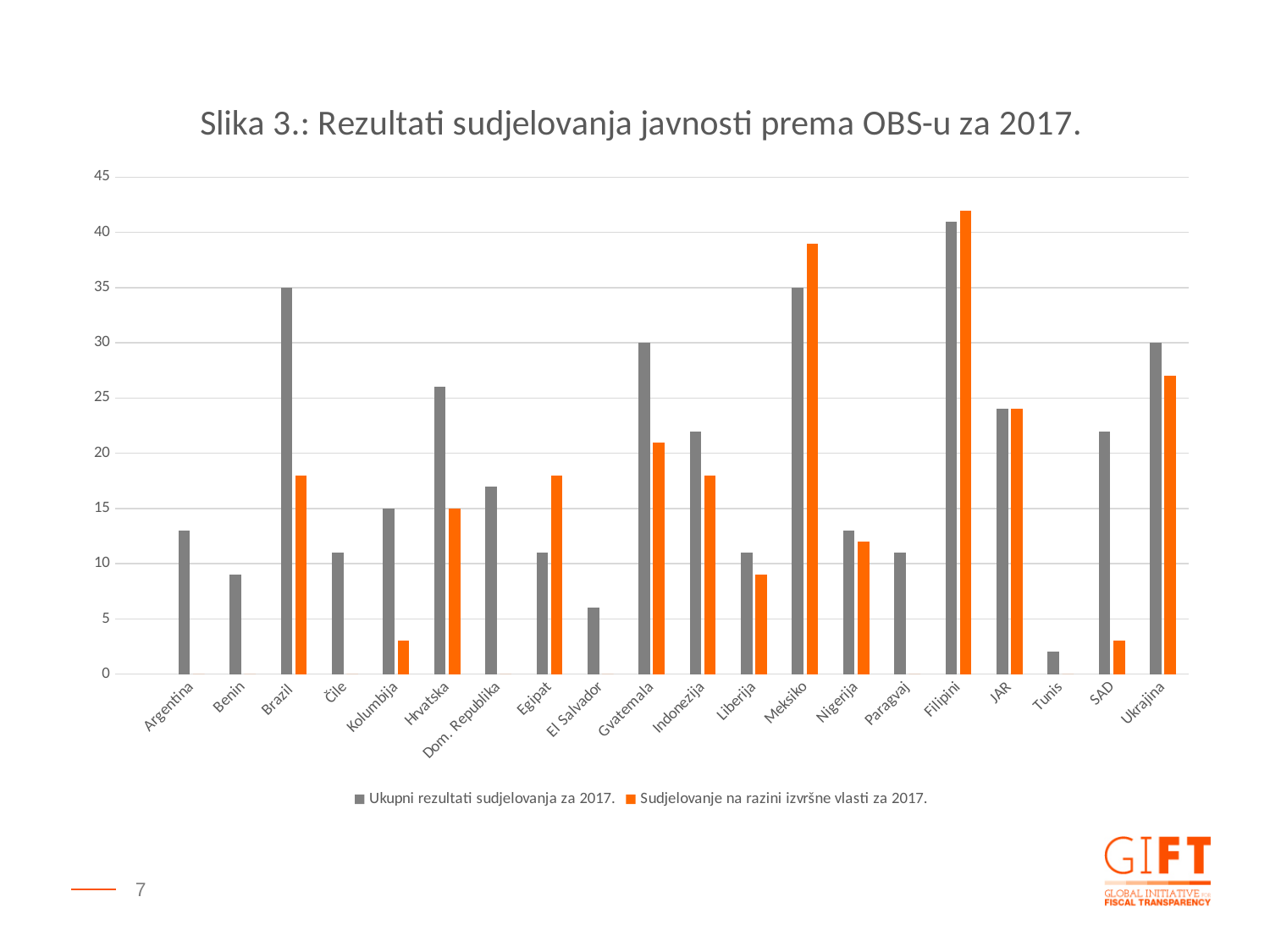
How many countries are shown on the x axis of the chart? 20 What is the title of the chart? Slika 3.: Rezultati sudjelovanja javnosti prema OBS-u za 2017. Is the value for Egipat in 'Sudjelovanje na razini izvršne vlasti za 2017.' greater or less than 15? greater Which country has the highest value for 'Ukupni rezultati sudjelovanja za 2017.'? Filipini Is the value for Hrvatska in 'Ukupni rezultati sudjelovanja za 2017.' greater or less than 20? greater What kind of chart is shown on the slide? bar chart Is the value for SAD in 'Sudjelovanje na razini izvršne vlasti za 2017.' greater or less than 5? less How many series does the legend list? 2 Which country has the highest value for 'Sudjelovanje na razini izvršne vlasti za 2017.'? Filipini Which country has the lowest non-zero value for 'Ukupni rezultati sudjelovanja za 2017.'? Tunis For Meksiko, which series has the larger value: 'Ukupni rezultati sudjelovanja za 2017.' or 'Sudjelovanje na razini izvršne vlasti za 2017.'? Sudjelovanje na razini izvršne vlasti za 2017.